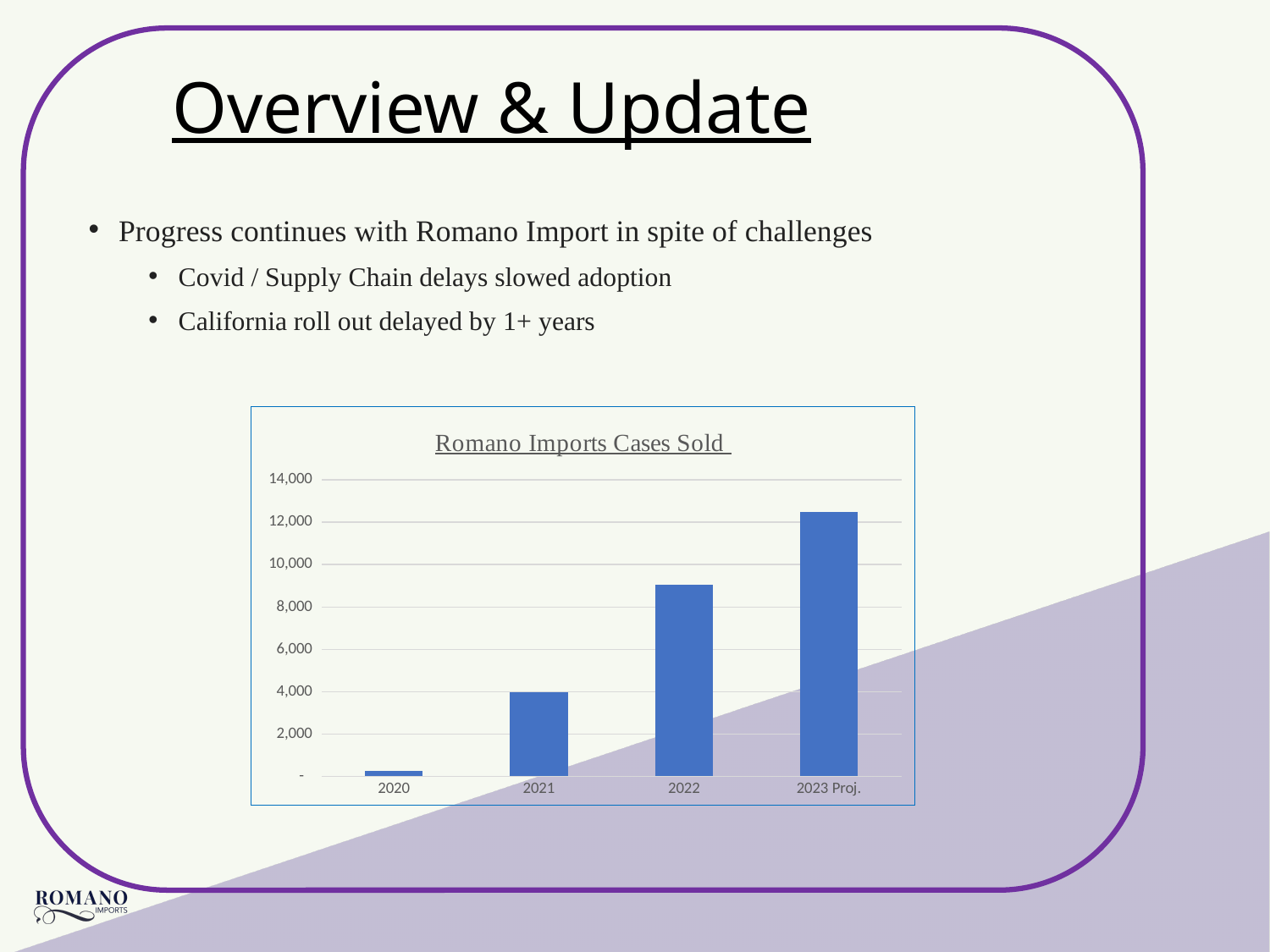
Is the value for 2022 greater or less than 10,000? less Is the value for 2020 greater or less than 2,000? less How many categories are shown on the x axis of the chart? 4 Is the value for 2023 Proj. greater or less than 12,000? greater What kind of chart is shown on the slide? bar chart Do the values rise or fall from 2020 to 2023 Proj.? rise Which is larger, the value for 2021 or the value for 2022? 2022 Which category has the highest value in the chart? 2023 Proj. What is the title of the chart? Romano Imports Cases Sold Which category has the lowest value in the chart? 2020